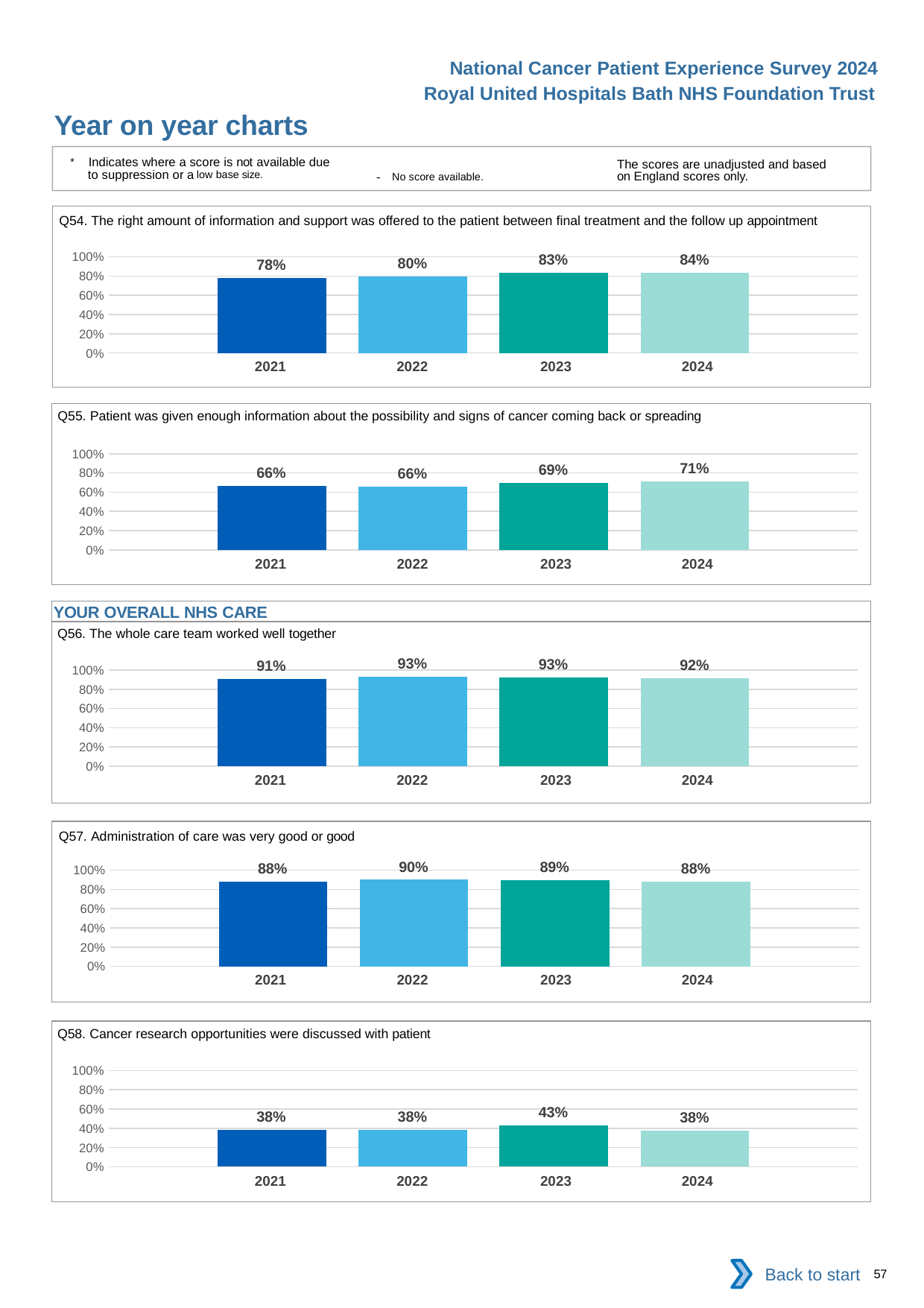
In the Q55 chart, do the values rise or fall from 2021 to 2024? rise How many bars are in the Q58 chart? 4 In the Q58 chart, what is the value for 2023? 43% In the Q54 chart, what is the value for 2024? 84% In the Q56 chart, is the value for 2022 greater or less than 80%? greater In the Q57 chart, which year has the highest value? 2022 What kind of chart is the Q54 chart? bar chart In the Q57 chart, which is larger, the value for 2022 or the value for 2024? 2022 In the Q54 chart, which year has the lowest value? 2021 In the Q55 chart, what is the difference between the 2024 and 2021 values? 5 percentage points In the Q58 chart, is the value for 2021 greater or less than 60%? less In the Q56 chart, what is the value for 2021? 91%